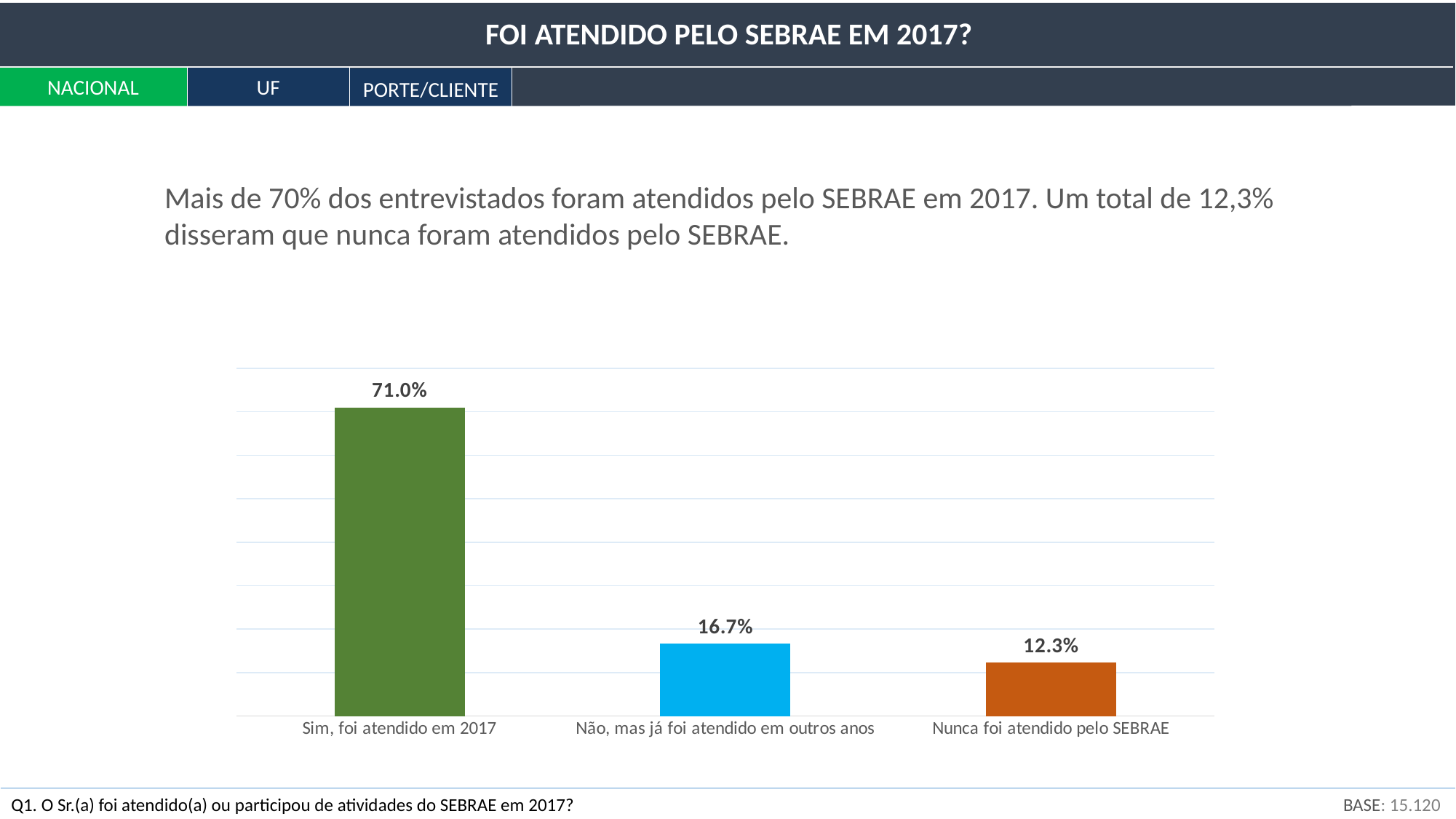
What is the value for "Nunca foi atendido pelo SEBRAE"? 12.3% What colour is the bar for "Sim, foi atendido em 2017"? Green How many categories are shown in the chart? 3 Do the values rise or fall from left to right across the categories? Fall Which category has the lowest value? Nunca foi atendido pelo SEBRAE What is the difference between the values for "Não, mas já foi atendido em outros anos" and "Nunca foi atendido pelo SEBRAE"? 4.4% Which category has the highest value? Sim, foi atendido em 2017 What is the difference between the values for "Sim, foi atendido em 2017" and "Nunca foi atendido pelo SEBRAE"? 58.7% What is the value for "Não, mas já foi atendido em outros anos"? 16.7% Which is larger: the value for "Não, mas já foi atendido em outros anos" or for "Nunca foi atendido pelo SEBRAE"? Não, mas já foi atendido em outros anos What is the value for "Sim, foi atendido em 2017"? 71.0% What kind of chart is shown on the slide? Bar chart